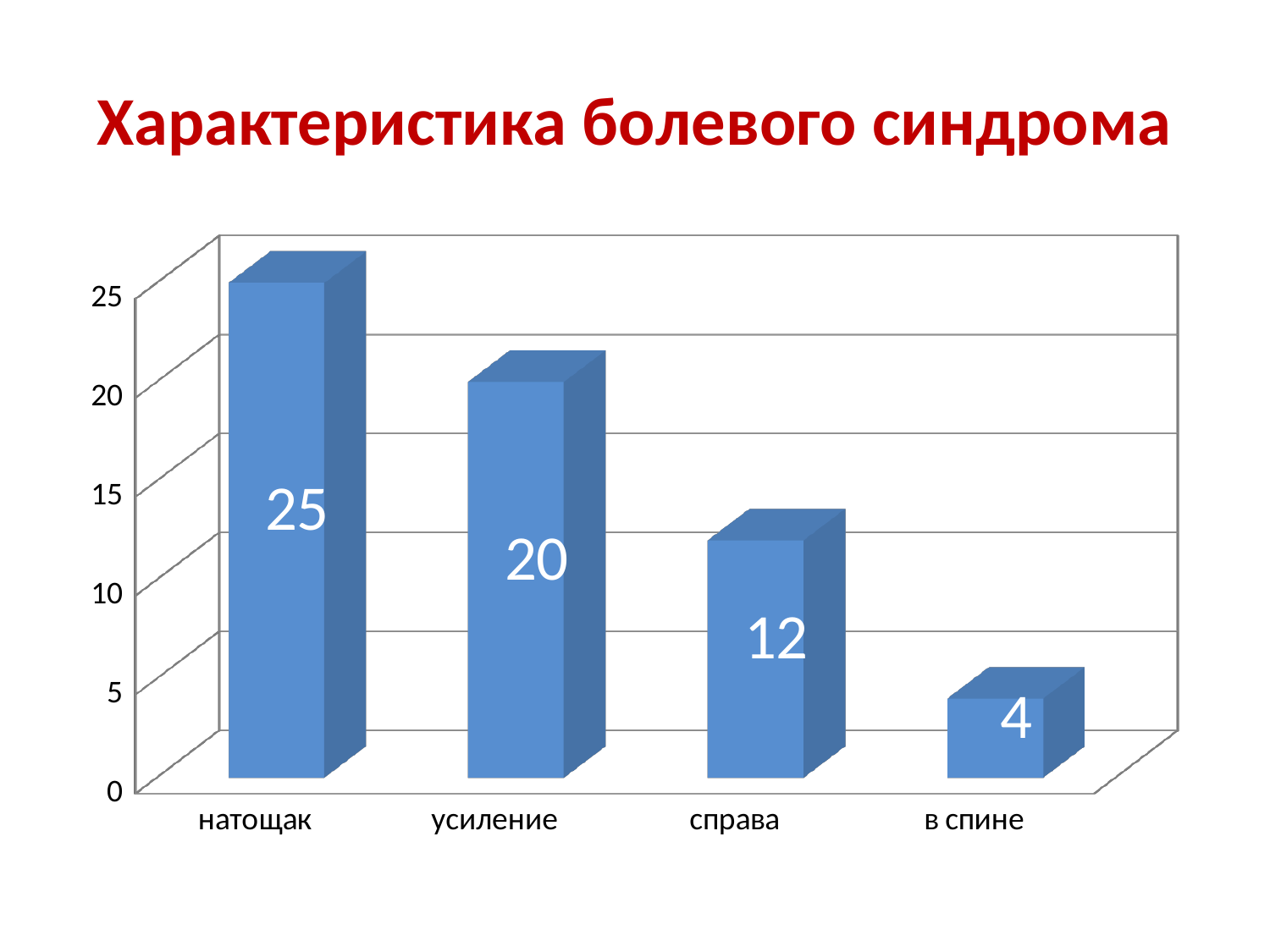
Which is larger, the value for усиление or the value for справа? усиление What is the value for справа? 12 What is the value for натощак? 25 What kind of chart is shown on the slide? bar chart What is the difference between the values for натощак and усиление? 5 Do the values rise or fall from left to right along the x axis? fall What is the value for усиление? 20 Which category has the highest value? натощак Which category has the lowest value? в спине How many categories are shown on the x axis? 4 What is the value for в спине? 4 What is the difference between the values for справа and в спине? 8